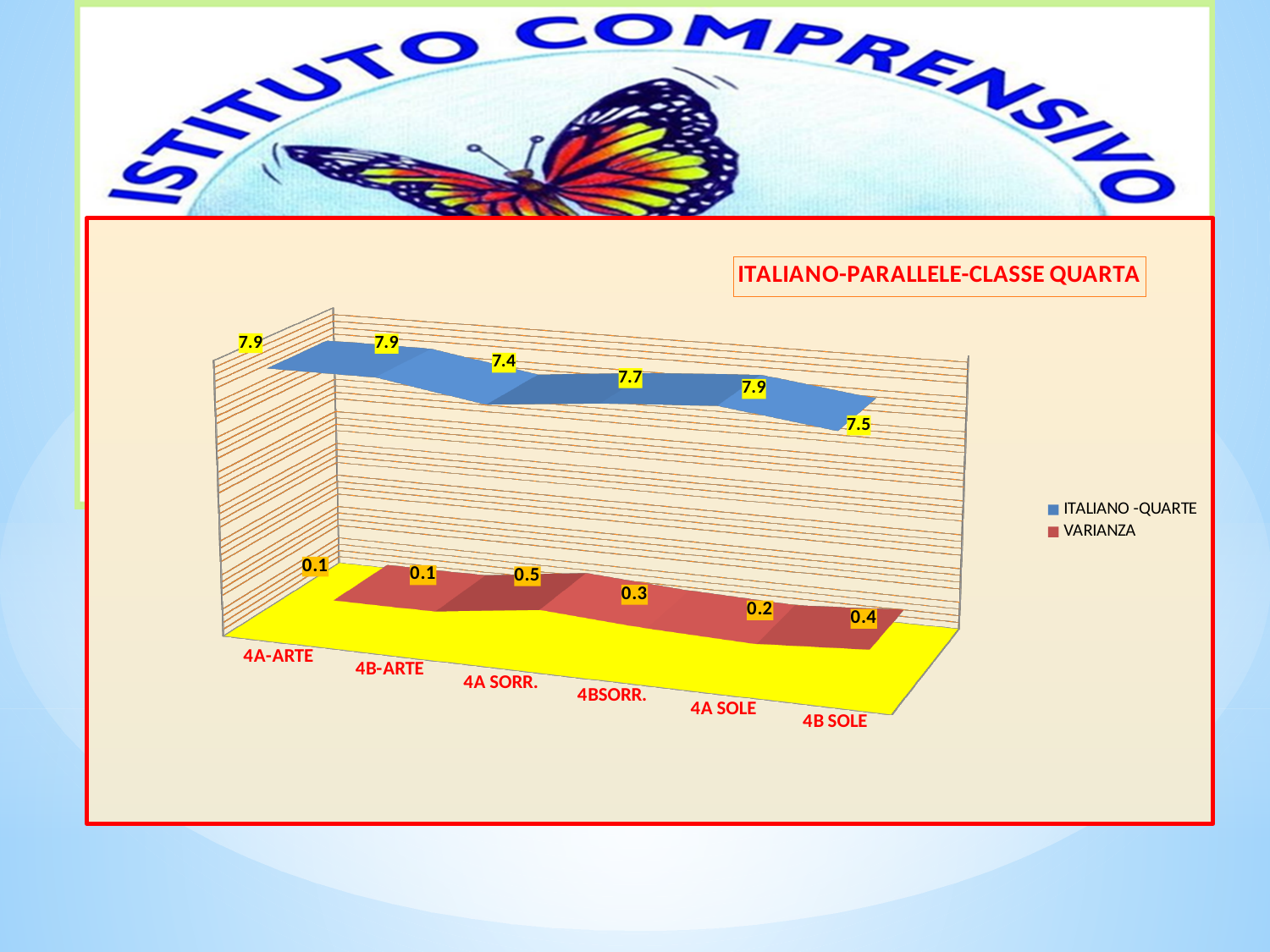
What is the title of the chart? ITALIANO-PARALLELE-CLASSE QUARTA What kind of chart is shown on the slide? 3D line chart How many categories are shown on the x axis? 6 What is the VARIANZA value for 4A SORR.? 0.5 Which category has the highest VARIANZA value? 4A SORR. Which category has the lowest ITALIANO -QUARTE value? 4A SORR. How many series does the legend list? 2 What is the ITALIANO -QUARTE value for 4B SOLE? 7.5 What is the difference between the ITALIANO -QUARTE values for 4A-ARTE and 4B SOLE? 0.4 What is the ITALIANO -QUARTE value for 4A SORR.? 7.4 What is the VARIANZA value for 4B SOLE? 0.4 Which has a larger VARIANZA value, 4BSORR. or 4A SOLE? 4BSORR.